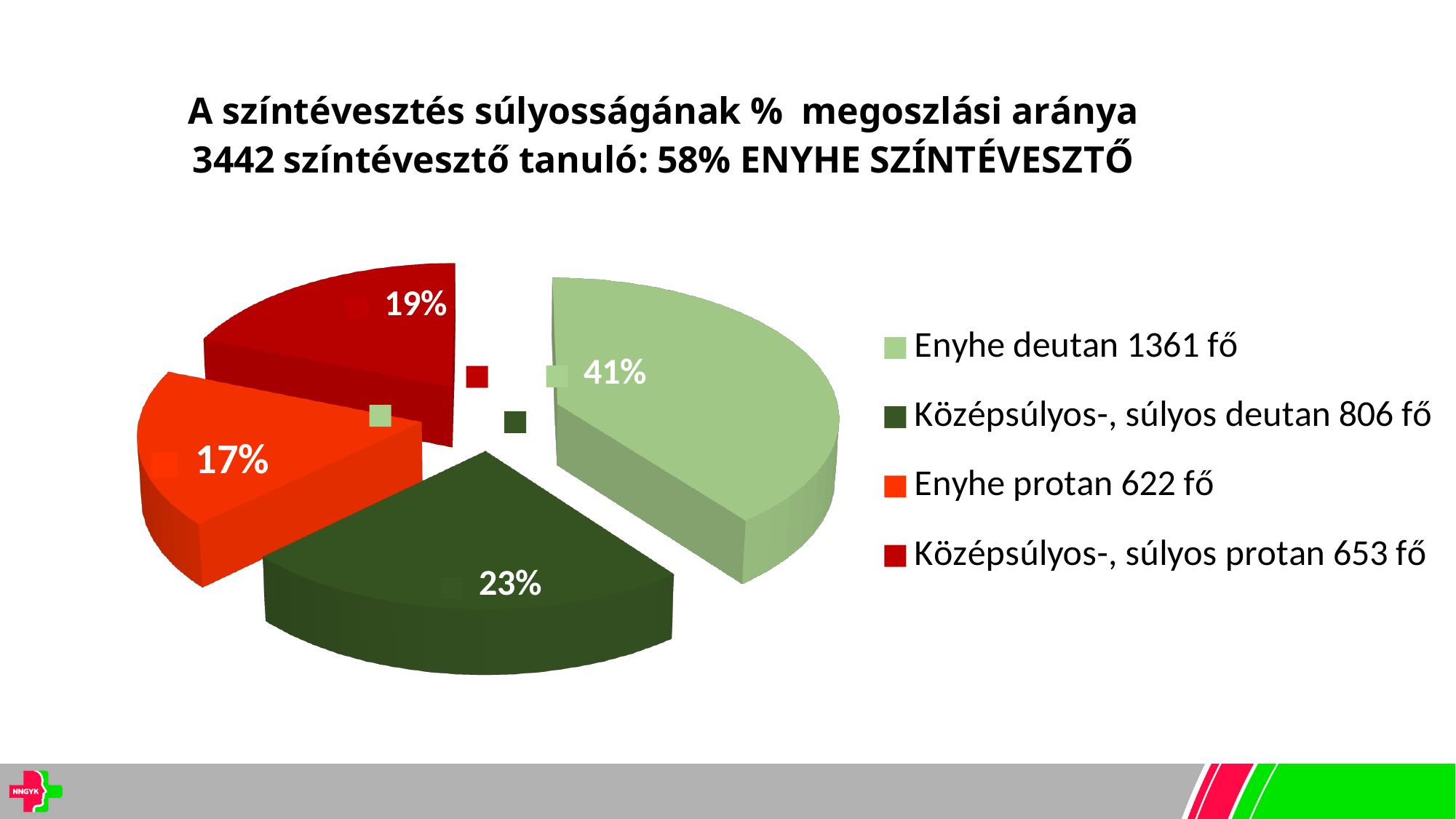
What percentage share does the Középsúlyos-, súlyos protan slice have? 19% How many slices does the pie chart have? 4 What kind of chart is shown on the slide? pie chart What colour is the Enyhe protan slice? orange-red What is the difference in percentage points between the Enyhe deutan slice and the Középsúlyos-, súlyos deutan slice? 18 What percentage share does the Középsúlyos-, súlyos deutan slice have? 23% How many entries does the legend list? 4 What percentage share does the Enyhe deutan slice have? 41% Which category has the smallest slice of the pie? Enyhe protan Which category has the largest slice of the pie? Enyhe deutan Which slice is larger: Középsúlyos-, súlyos deutan or Középsúlyos-, súlyos protan? Középsúlyos-, súlyos deutan